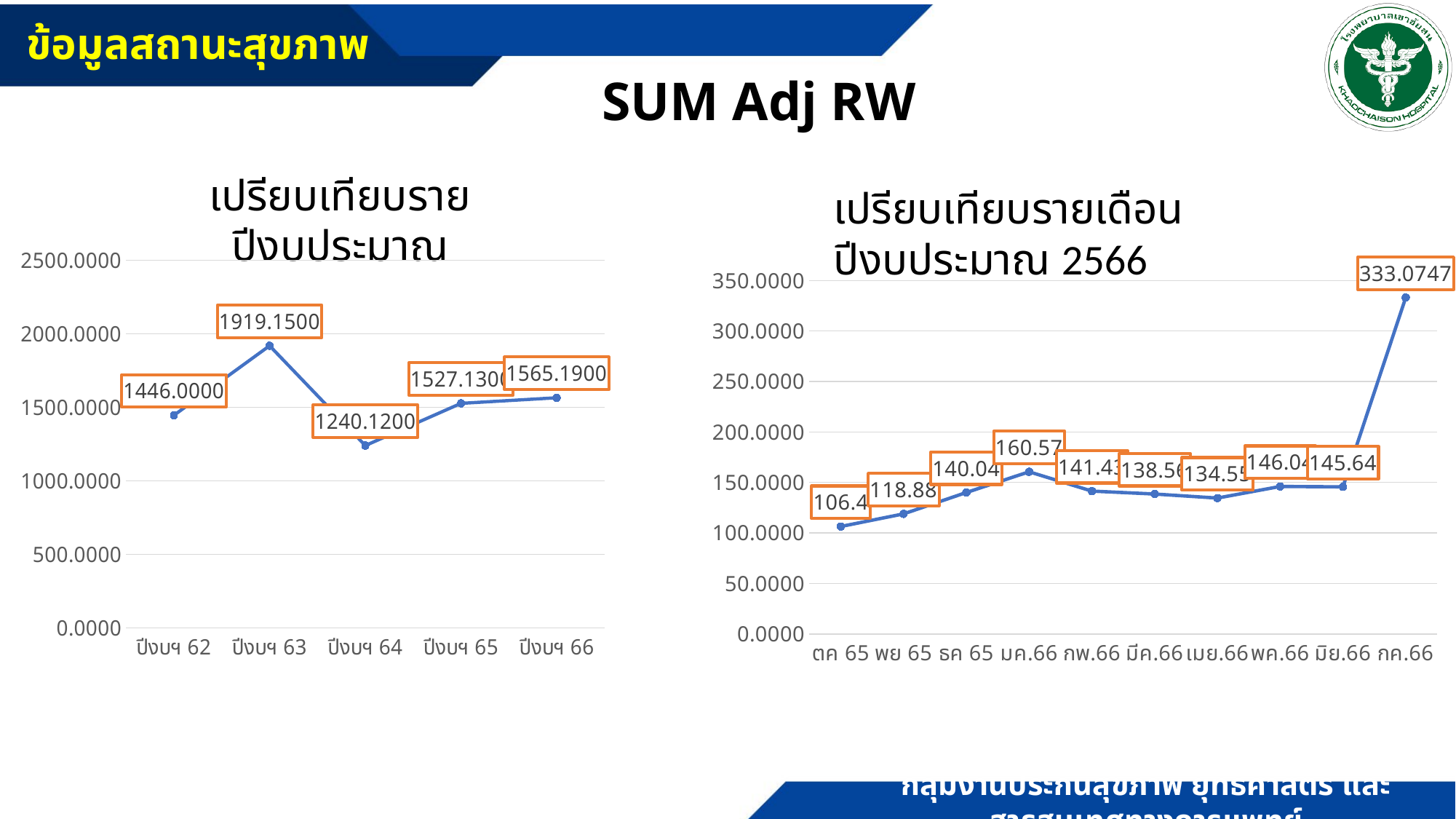
What kind of chart is the left chart titled เปรียบเทียบรายปีงบประมาณ? line chart In the right chart (เปรียบเทียบรายเดือนปีงบประมาณ 2566), which month has the lowest value? ตค 65 In the right chart (เปรียบเทียบรายเดือนปีงบประมาณ 2566), which is larger, the value for มค.66 or the value for เมย.66? มค.66 In the right chart (เปรียบเทียบรายเดือนปีงบประมาณ 2566), is the value for ตค 65 greater or less than 150.0000? less In the right chart (เปรียบเทียบรายเดือนปีงบประมาณ 2566), which month has the highest value? กค.66 In the left chart (เปรียบเทียบรายปีงบประมาณ), what is the difference between the values for ปีงบฯ 63 and ปีงบฯ 64? 679.0300 In the left chart (เปรียบเทียบรายปีงบประมาณ), which fiscal year has the lowest value? ปีงบฯ 64 In the left chart (เปรียบเทียบรายปีงบประมาณ), what is the value for ปีงบฯ 63? 1919.1500 In the left chart (เปรียบเทียบรายปีงบประมาณ), which fiscal year has the highest value? ปีงบฯ 63 How many fiscal years are plotted in the left chart (เปรียบเทียบรายปีงบประมาณ)? 5 How many months are plotted in the right chart (เปรียบเทียบรายเดือนปีงบประมาณ 2566)? 10 In the right chart (เปรียบเทียบรายเดือนปีงบประมาณ 2566), what is the value for กค.66? 333.0747